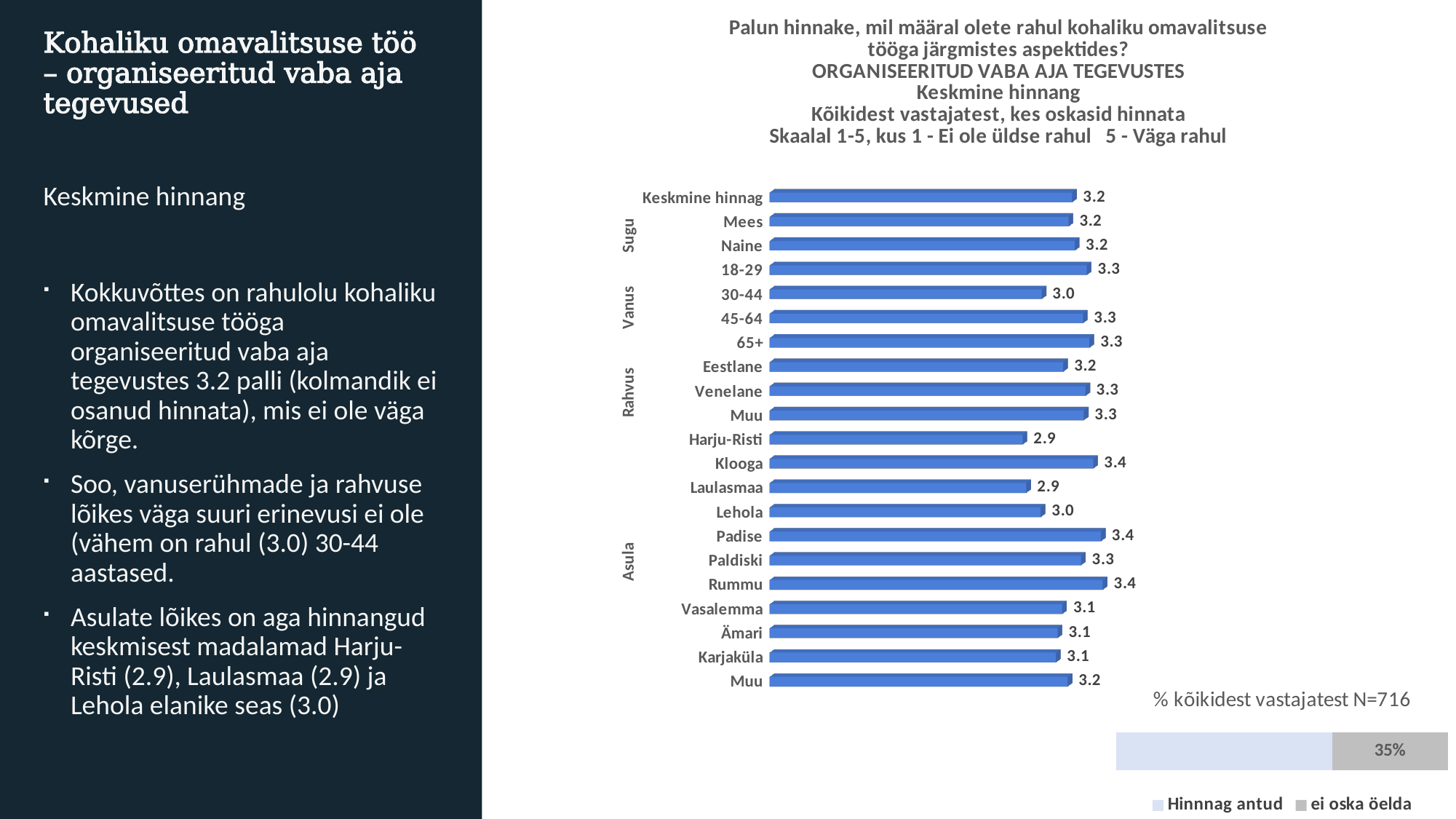
In the main bar chart, which has a higher value, Padise or Lehola? Padise In the main bar chart, what is the value for the 30-44 age group? 3.0 How many series does the legend of the small stacked bar chart at the bottom right list? 2 In the main bar chart, what is the value for Rummu? 3.4 What kind of chart is the main chart on the slide? bar chart In the main bar chart, what is the average rating (Keskmine hinnag) for organised leisure activities? 3.2 In the small stacked bar chart at the bottom right, what is the value for 'ei oska öelda'? 35% In the main bar chart, which nationality group (Rahvus) has the lowest rating? Eestlane In the main bar chart, what is the difference between the values for Klooga and Harju-Risti? 0.5 In the main bar chart, what is the value for Harju-Risti? 2.9 How many categories are plotted in the main bar chart? 21 In the main bar chart, which age group (Vanus) has the lowest rating? 30-44